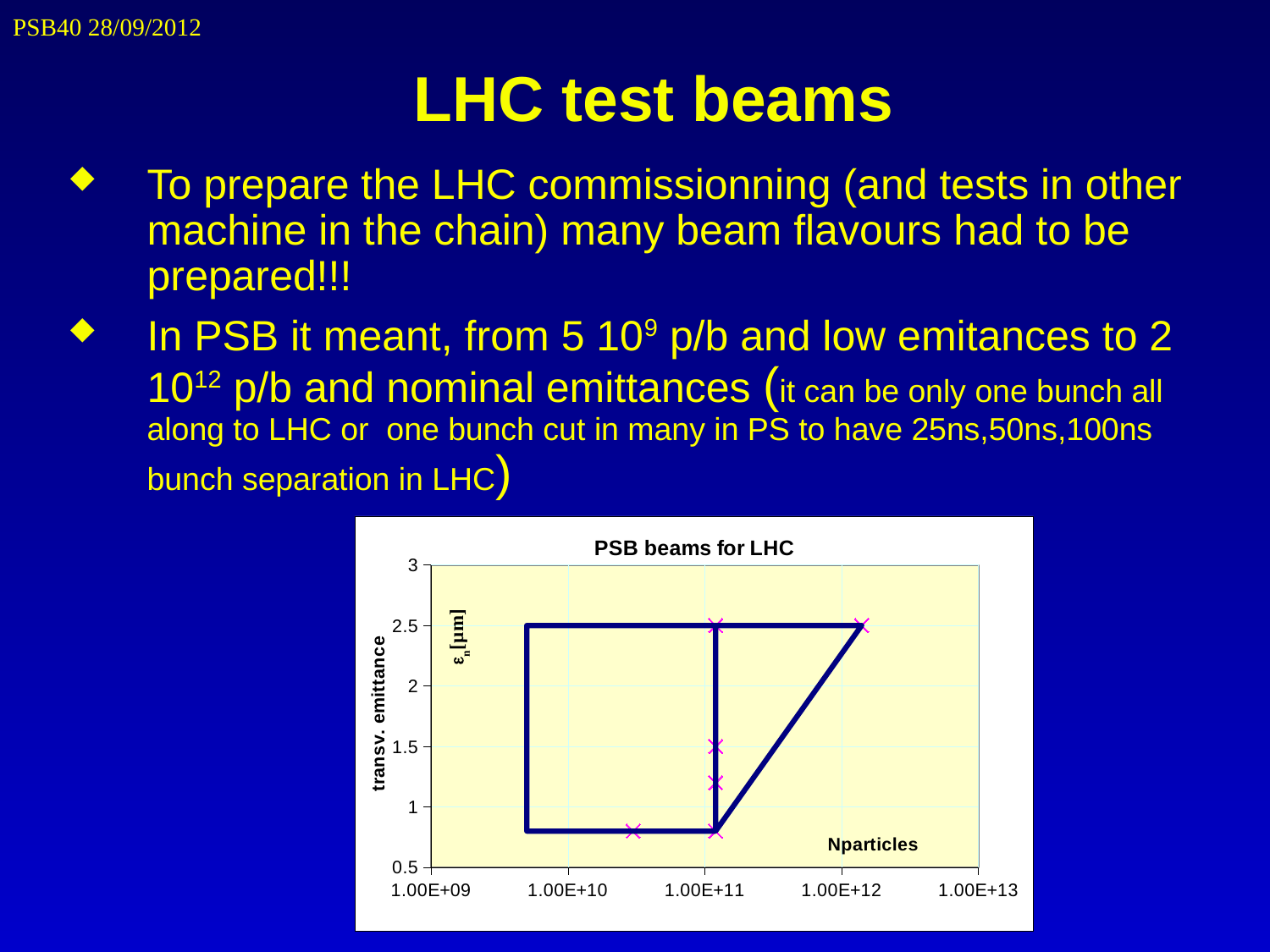
What is the smallest value shown on the x axis of the chart? 1.00E+09 What is the label of the x axis of the chart? Nparticles What is the title of the chart on the slide? PSB beams for LHC How many marker points are plotted on the chart? 6 Is the Nparticles value of the rightmost marker greater or less than 1.00E+12? greater Is the Nparticles value of the leftmost marker greater or less than 1.00E+11? less What is the largest value shown on the x axis of the chart? 1.00E+13 What kind of chart is shown on the slide? scatter chart with lines Is the transverse emittance of the highest plotted markers greater or less than 2? greater What is the lowest value shown on the y axis of the chart? 0.5 What is the highest value shown on the y axis (transv. emittance) of the chart? 3